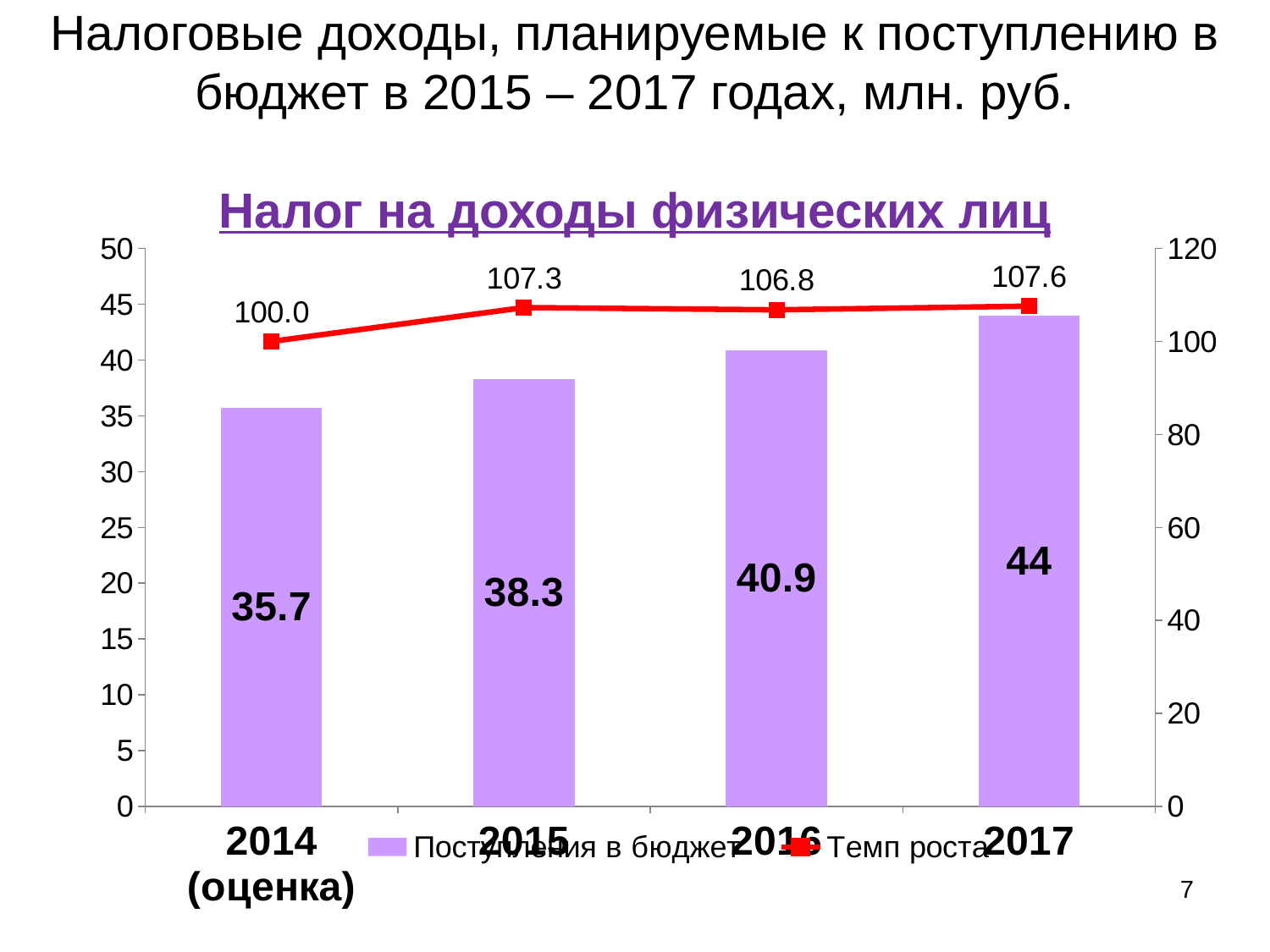
What is the value of 'Темп роста' for 2016? 106.8 Do the values of 'Поступления в бюджет' rise or fall from 2014 to 2017? rise How many years are shown on the x axis? 4 Which year has the highest value of 'Поступления в бюджет'? 2017 Which year has the lowest value of 'Темп роста'? 2014 (оценка) What is the value of 'Поступления в бюджет' for 2014 (оценка)? 35.7 How many series does the legend list? 2 Is the value of 'Поступления в бюджет' for 2016 greater or less than 40? greater What is the value of 'Поступления в бюджет' for 2015? 38.3 Which is larger, 'Темп роста' in 2015 or in 2016? 2015 What is the title of the chart? Налог на доходы физических лиц What is the difference between 'Поступления в бюджет' in 2017 and in 2016? 3.1